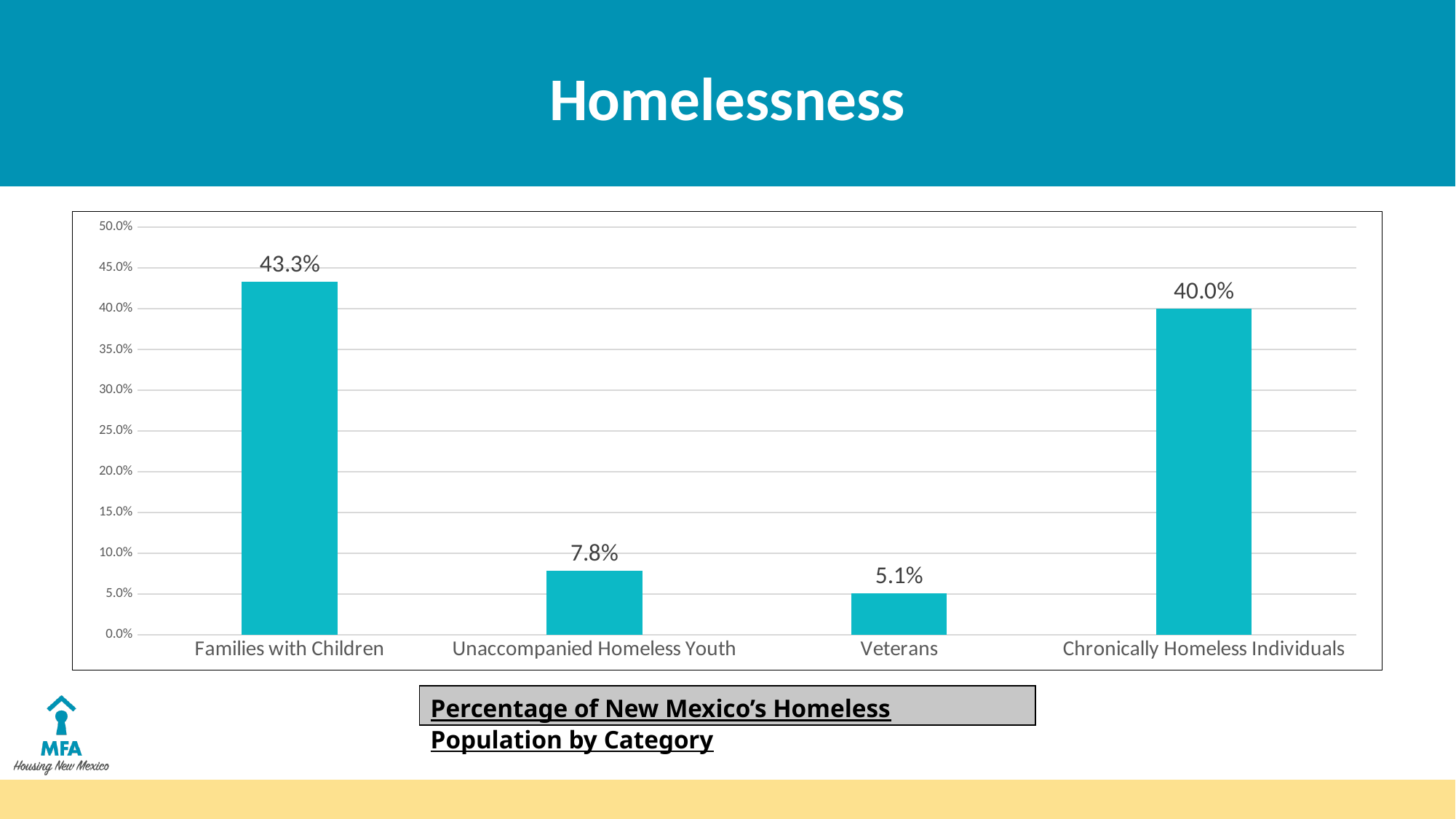
What is the difference between the percentages for Families with Children and Chronically Homeless Individuals? 3.3% Which is larger, the value for Unaccompanied Homeless Youth or the value for Veterans? Unaccompanied Homeless Youth Which category has the lowest percentage? Veterans Which category has the highest percentage? Families with Children What percentage is shown for Veterans? 5.1% What is the caption below the chart? Percentage of New Mexico's Homeless Population by Category How many categories are shown on the chart? 4 What percentage is shown for Families with Children? 43.3% What kind of chart is shown on the slide? Bar chart What percentage is shown for Unaccompanied Homeless Youth? 7.8% What is the difference between the percentages for Unaccompanied Homeless Youth and Veterans? 2.7% What percentage is shown for Chronically Homeless Individuals? 40.0%